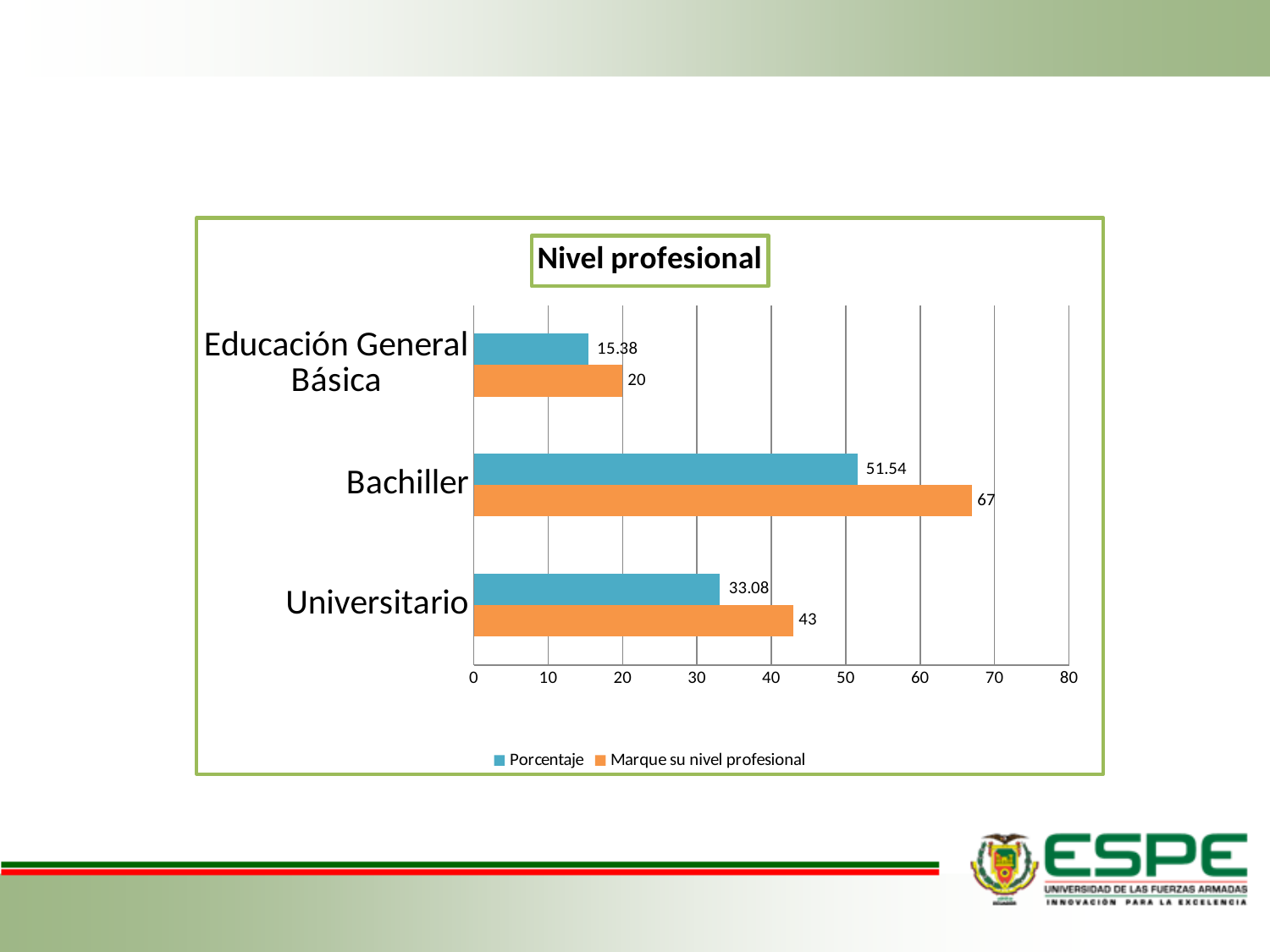
Is the Marque su nivel profesional value for Bachiller greater or less than 60? greater What is the Porcentaje value for Bachiller? 51.54 What is the Marque su nivel profesional value for Universitario? 43 How many categories are shown on the chart? 3 What kind of chart is shown? bar chart Which is larger: the Porcentaje value for Universitario or for Educación General Básica? Universitario What is the difference between the Marque su nivel profesional values for Bachiller and Universitario? 24 Which category has the lowest Porcentaje value? Educación General Básica Which category has the highest Marque su nivel profesional value? Bachiller How many series does the legend list? 2 What is the Porcentaje value for Educación General Básica? 15.38 What is the title of the chart? Nivel profesional